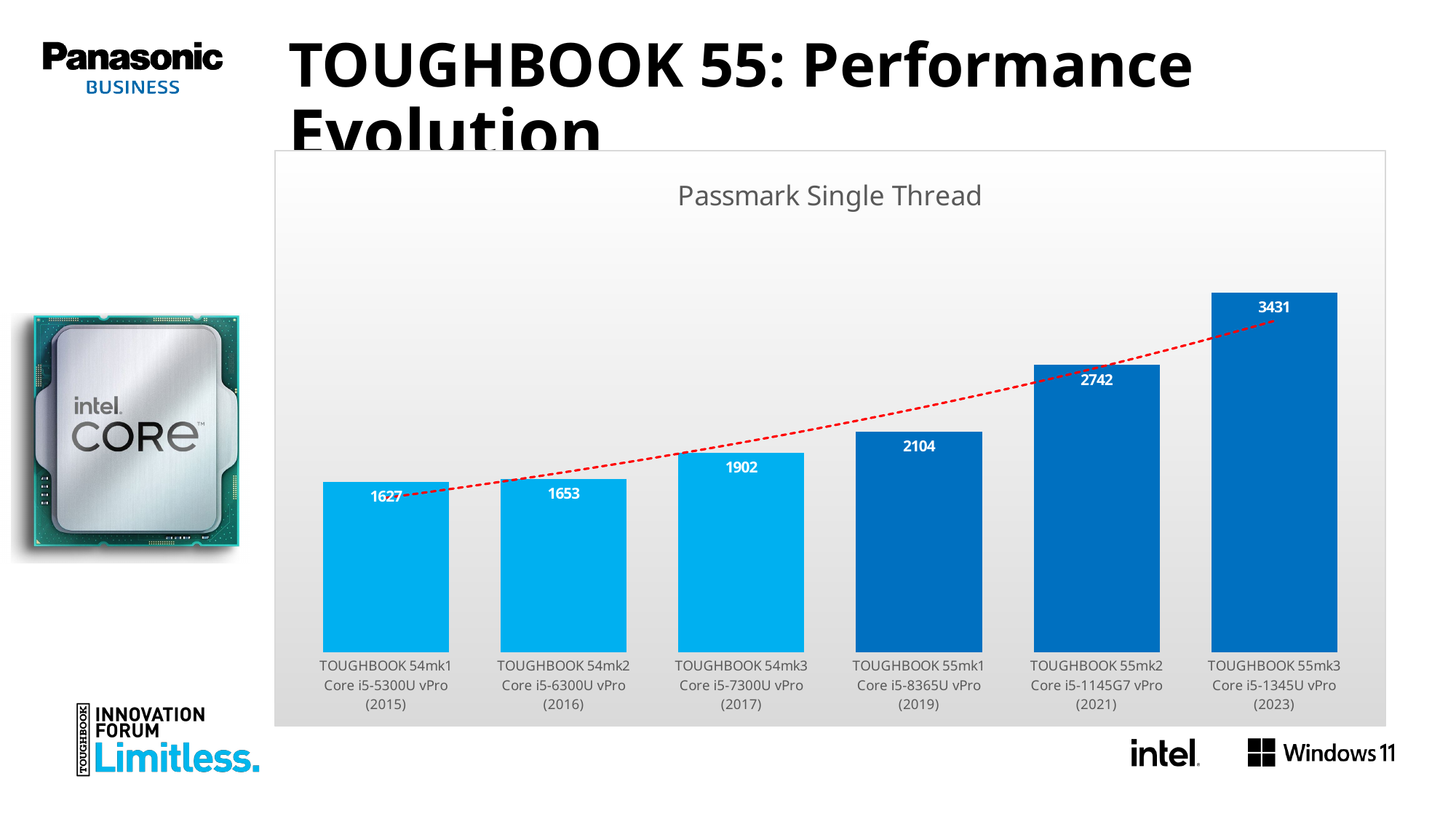
What kind of chart is shown on the slide? Bar chart What is the difference between the Passmark Single Thread scores of TOUGHBOOK 54mk2 and TOUGHBOOK 54mk1? 26 What is the difference between the Passmark Single Thread scores of TOUGHBOOK 55mk3 and TOUGHBOOK 55mk2? 689 What is the Passmark Single Thread score for TOUGHBOOK 55mk3 (2023)? 3431 Which model has the lowest Passmark Single Thread score? TOUGHBOOK 54mk1 Which has a higher Passmark Single Thread score, TOUGHBOOK 54mk3 or TOUGHBOOK 55mk1? TOUGHBOOK 55mk1 Do the Passmark Single Thread scores rise or fall from 2015 to 2023? Rise What is the Passmark Single Thread score for TOUGHBOOK 55mk1 (2019)? 2104 Which model has the highest Passmark Single Thread score? TOUGHBOOK 55mk3 How many models are shown in the chart? 6 What is the Passmark Single Thread score for TOUGHBOOK 54mk1 (2015)? 1627 What is the title of the chart? Passmark Single Thread